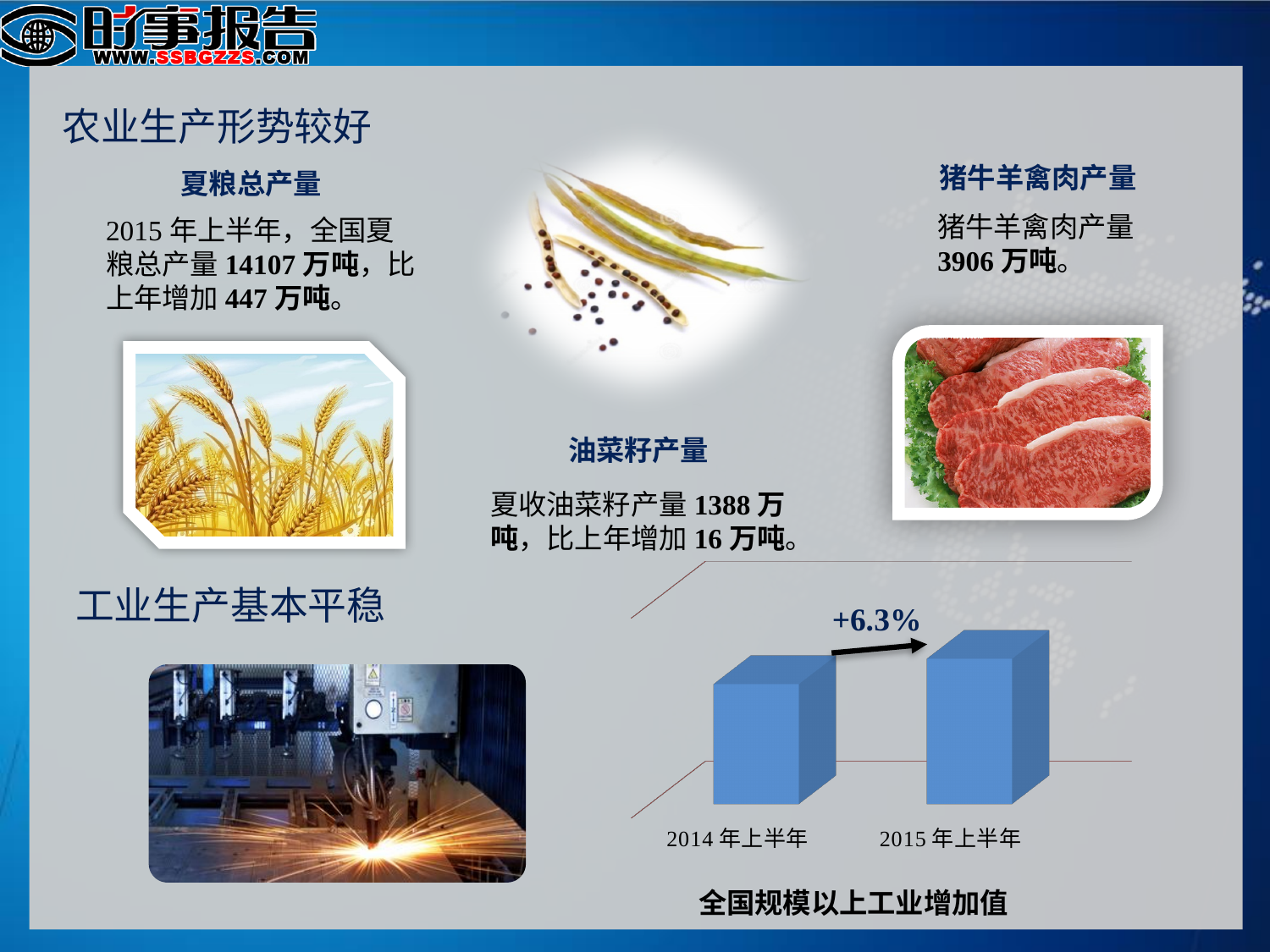
In the chart titled 全国规模以上工业增加值, which category has the taller bar? 2015 年上半年 In the chart titled 全国规模以上工业增加值, do the values rise or fall from 2014 年上半年 to 2015 年上半年? rise What is the title printed below the bar chart on the slide? 全国规模以上工业增加值 In the chart titled 全国规模以上工业增加值, which category has the shorter bar? 2014 年上半年 In the chart titled 全国规模以上工业增加值, is the bar for 2015 年上半年 taller or shorter than the bar for 2014 年上半年? taller What percentage change is annotated above the bars in the chart titled 全国规模以上工业增加值? +6.3% What kind of chart is shown at the bottom right of the slide? bar chart How many bars does the chart titled 全国规模以上工业增加值 have? 2